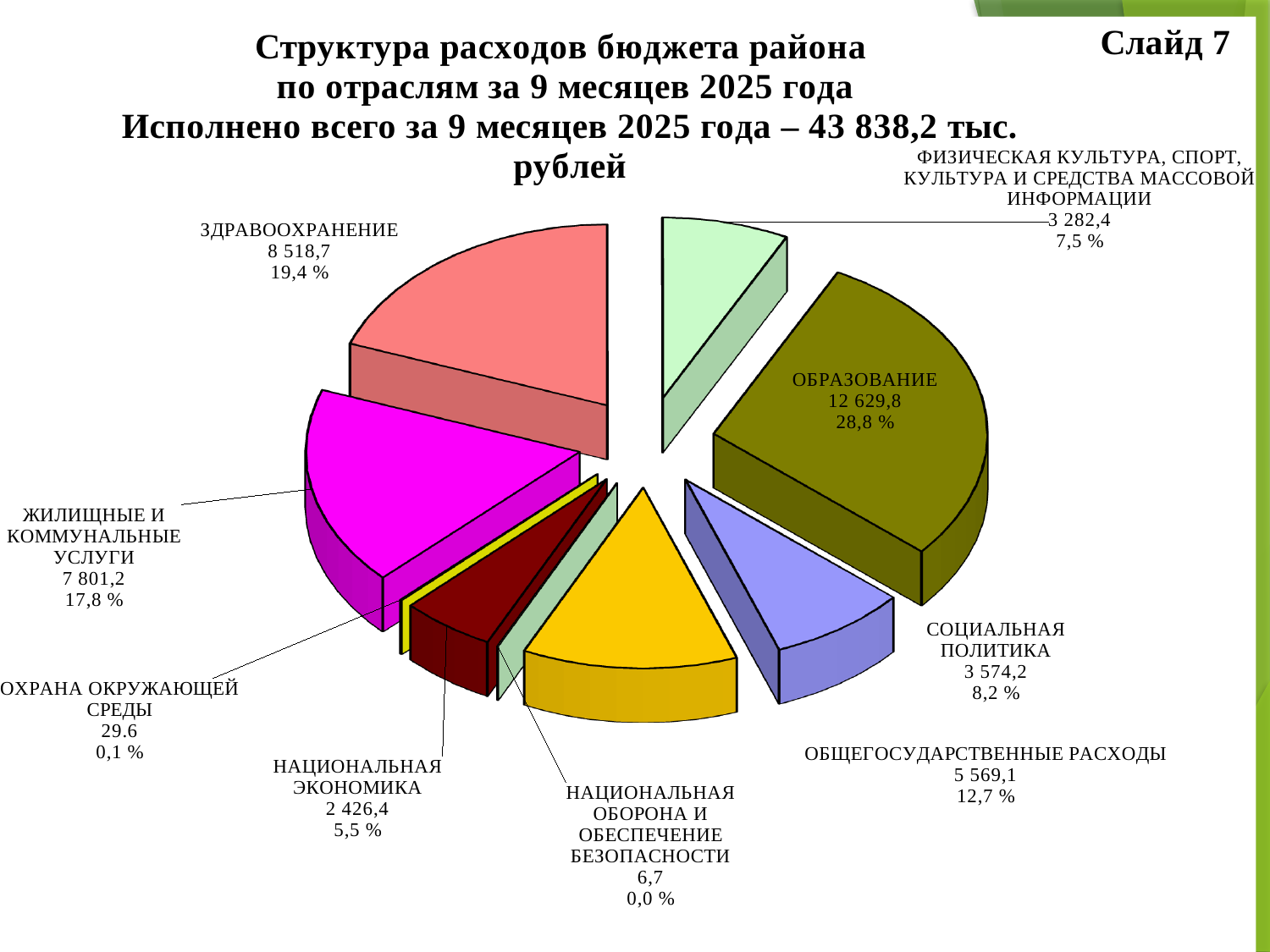
How many categories (slices) does the pie chart have? 9 What is the difference between the values for ОБРАЗОВАНИЕ and ЗДРАВООХРАНЕНИЕ? 4 111,1 What is the value shown for НАЦИОНАЛЬНАЯ ЭКОНОМИКА? 2 426,4 Which category has the largest slice of the pie? ОБРАЗОВАНИЕ What is the value shown for ЗДРАВООХРАНЕНИЕ? 8 518,7 What share of the pie does ЖИЛИЩНЫЕ И КОММУНАЛЬНЫЕ УСЛУГИ represent? 17,8 % What share of the pie does СОЦИАЛЬНАЯ ПОЛИТИКА represent? 8,2 % Which is larger, the value for ЗДРАВООХРАНЕНИЕ or the value for ЖИЛИЩНЫЕ И КОММУНАЛЬНЫЕ УСЛУГИ? ЗДРАВООХРАНЕНИЕ What kind of chart is shown on the slide? Pie chart What is the value shown for ОБРАЗОВАНИЕ? 12 629,8 What is the value shown for ОБЩЕГОСУДАРСТВЕННЫЕ РАСХОДЫ? 5 569,1 Which category has the smallest slice of the pie? НАЦИОНАЛЬНАЯ ОБОРОНА И ОБЕСПЕЧЕНИЕ БЕЗОПАСНОСТИ